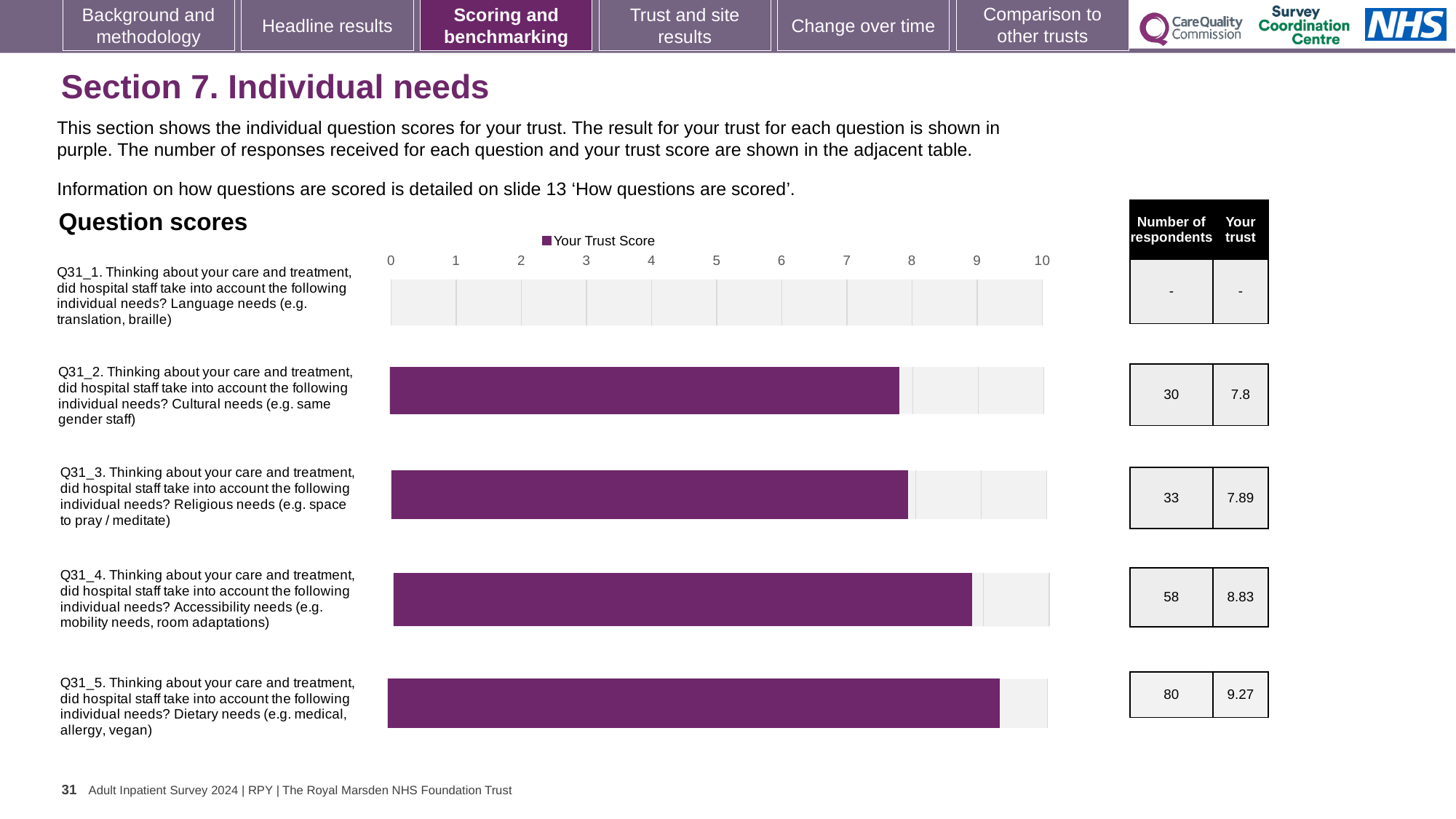
What is the trust score for Q31_2 (Cultural needs)? 7.8 How many respondents answered Q31_3 (Religious needs)? 33 Which has a higher trust score, Q31_3 (Religious needs) or Q31_4 (Accessibility needs)? Q31_4 (Accessibility needs) Is the trust score for Q31_5 (Dietary needs) greater or less than 9? greater What is the trust score for Q31_4 (Accessibility needs)? 8.83 How many questions are listed in the chart? 5 What is the trust score for Q31_5 (Dietary needs)? 9.27 Which question has the highest trust score? Q31_5 (Dietary needs) What is the difference between the trust scores for Q31_5 and Q31_2? 1.47 Among the questions with a plotted bar, which has the lowest trust score? Q31_2 (Cultural needs) What series does the chart legend show? Your Trust Score What type of chart is shown? Bar chart